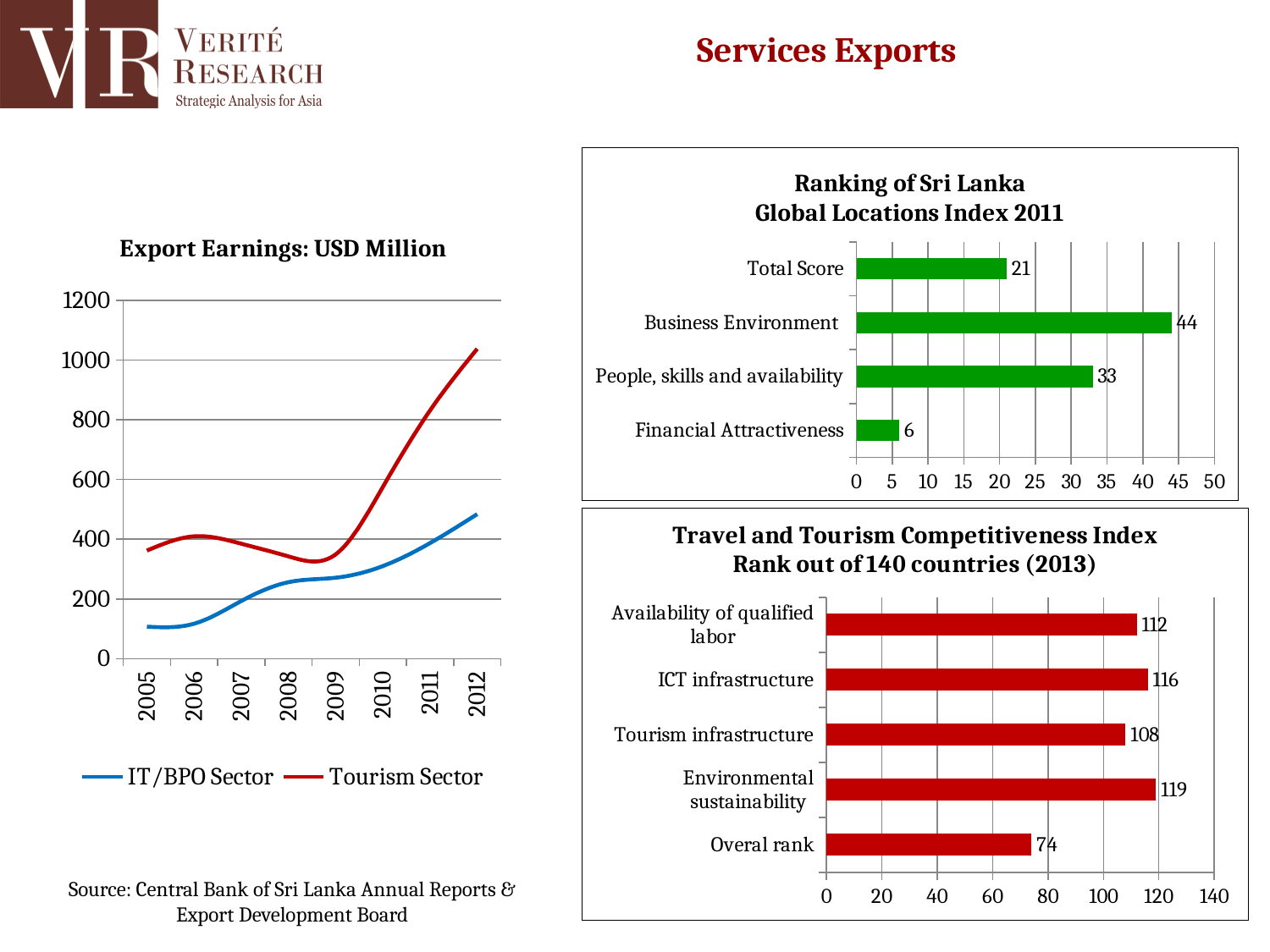
In the 'Travel and Tourism Competitiveness Index' chart, what is the Overal rank? 74 What kind of chart is 'Export Earnings: USD Million'? Line chart In the 'Ranking of Sri Lanka Global Locations Index 2011' chart, how many categories are shown? 4 In the 'Ranking of Sri Lanka Global Locations Index 2011' chart, what is the difference between People, skills and availability and Total Score? 12 In the 'Ranking of Sri Lanka Global Locations Index 2011' chart, which category has the highest value? Business Environment In the 'Travel and Tourism Competitiveness Index' chart, which is larger: Tourism infrastructure or Availability of qualified labor? Availability of qualified labor In the 'Travel and Tourism Competitiveness Index' chart, which category has the highest value? Environmental sustainability In the 'Travel and Tourism Competitiveness Index' chart, what is the difference between Environmental sustainability and Tourism infrastructure? 11 In the 'Travel and Tourism Competitiveness Index' chart, what is the rank for ICT infrastructure? 116 In the 'Export Earnings: USD Million' chart, is the value for the Tourism Sector in 2012 greater or less than 1000? greater In the 'Ranking of Sri Lanka Global Locations Index 2011' chart, what is the value for Business Environment? 44 In the 'Ranking of Sri Lanka Global Locations Index 2011' chart, what is the value for Financial Attractiveness? 6